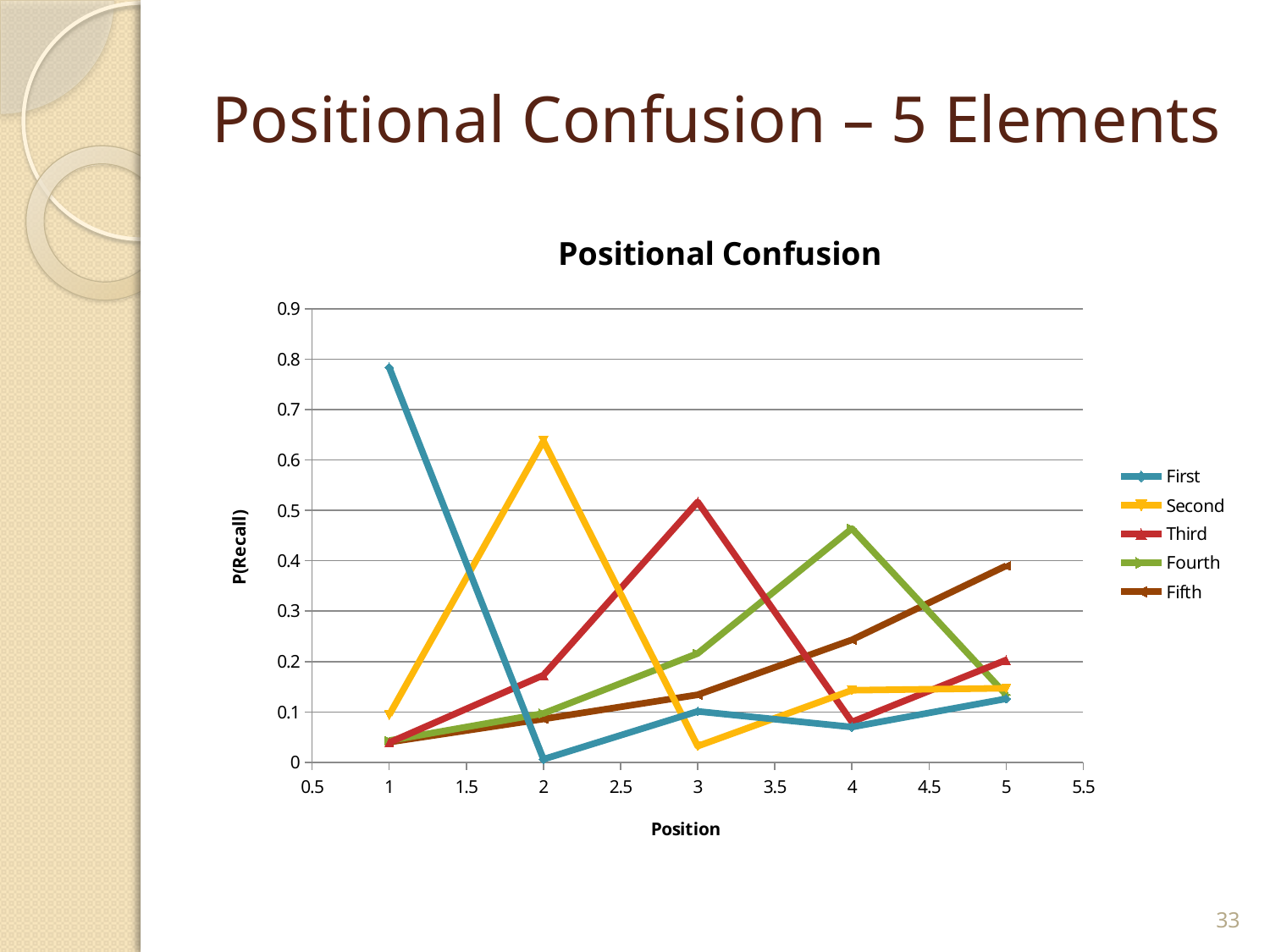
Is the value for the Fourth series at position 4 greater or less than 0.4? greater What is the label on the vertical axis of the chart? P(Recall) Is the value for the Fifth series at position 5 greater or less than 0.3? greater How many series does the legend list? 5 Which series has the lowest value at position 2? First What kind of chart is shown on the slide? line chart What is the title of the chart? Positional Confusion Is the value for the Third series at position 3 greater or less than 0.4? greater At position 5, which series has the larger value, Fifth or First? Fifth Which series has the highest value at position 1? First